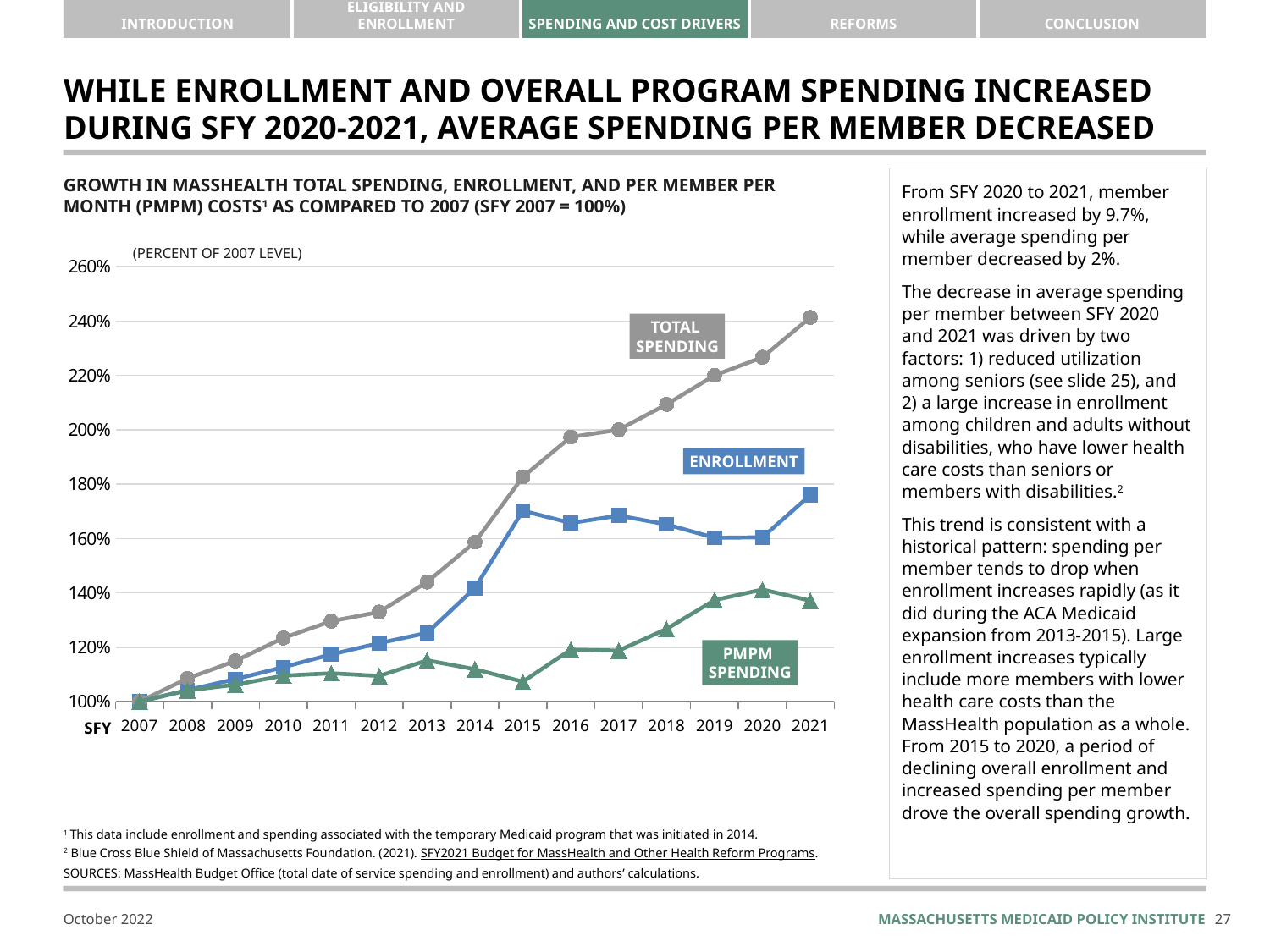
What kind of chart is shown on the slide? line chart How many series are plotted on the chart? 3 Does Total Spending generally rise or fall from SFY 2007 to SFY 2021? rise Is the value for Total Spending in SFY 2020 greater or less than 220%? greater Which series has the lowest value in SFY 2021? PMPM Spending How many fiscal years are plotted along the x axis of the chart? 15 Which series has the highest value in SFY 2021? Total Spending What is the value of Total Spending in SFY 2007? 100% Is the value for Enrollment in SFY 2021 greater or less than 180%? less Which series is larger in SFY 2019, Enrollment or PMPM Spending? Enrollment